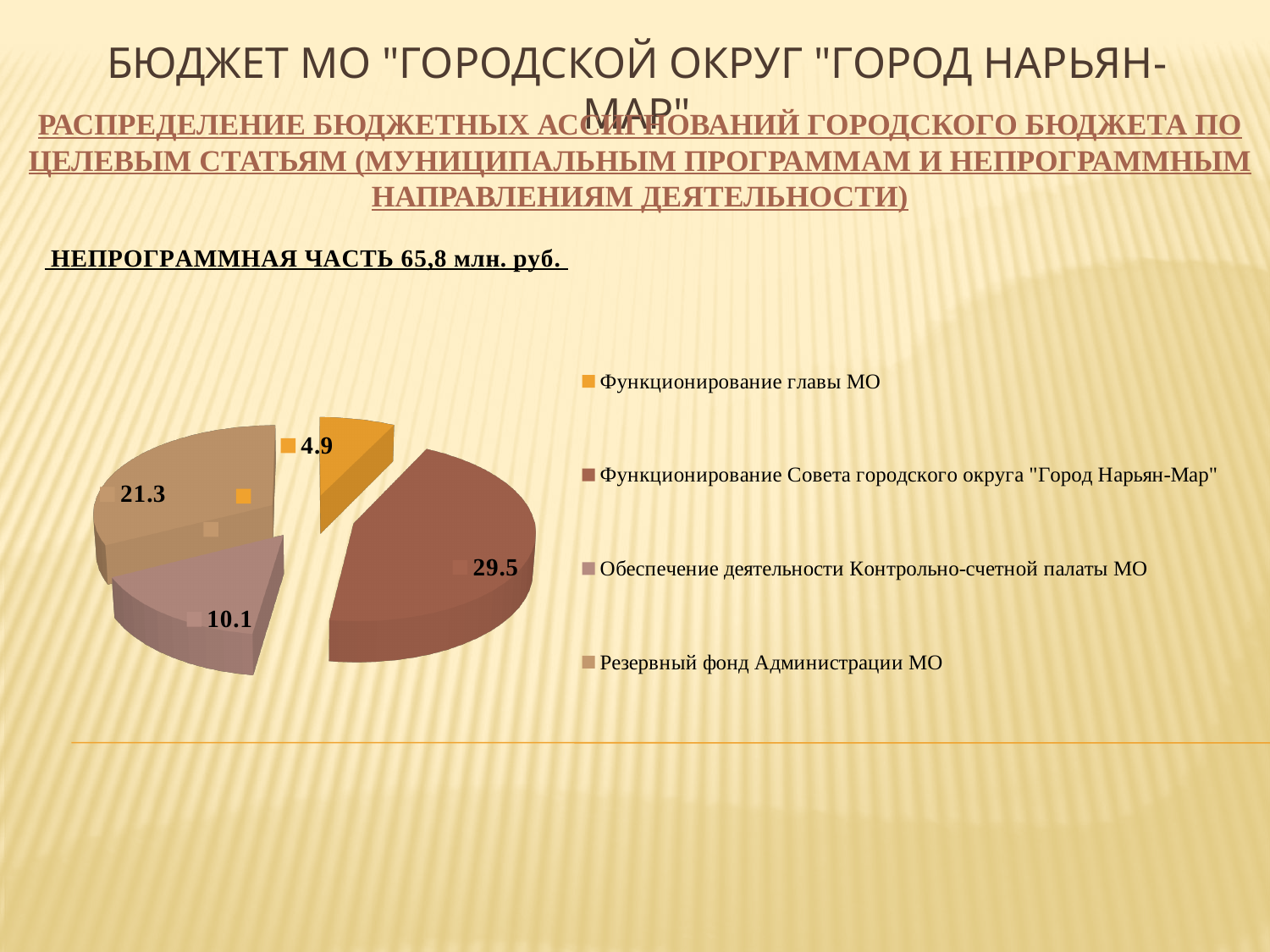
What is the difference between the values for "Функционирование Совета городского округа "Город Нарьян-Мар"" and "Резервный фонд Администрации МО"? 8.2 What is the value for "Функционирование Совета городского округа "Город Нарьян-Мар""? 29.5 How many slices does the pie chart have? 4 What is the value for "Резервный фонд Администрации МО"? 21.3 Which category has the smallest slice of the pie? Функционирование главы МО Which category has the largest slice of the pie? Функционирование Совета городского округа "Город Нарьян-Мар" What is the value for "Обеспечение деятельности Контрольно-счетной палаты МО"? 10.1 What type of chart is shown on the slide? pie chart Which is larger: the value for "Резервный фонд Администрации МО" or for "Обеспечение деятельности Контрольно-счетной палаты МО"? Резервный фонд Администрации МО What colour is the slice for "Функционирование главы МО"? orange What is the value for "Функционирование главы МО"? 4.9 What is the total of all the slice values shown on the pie chart? 65.8